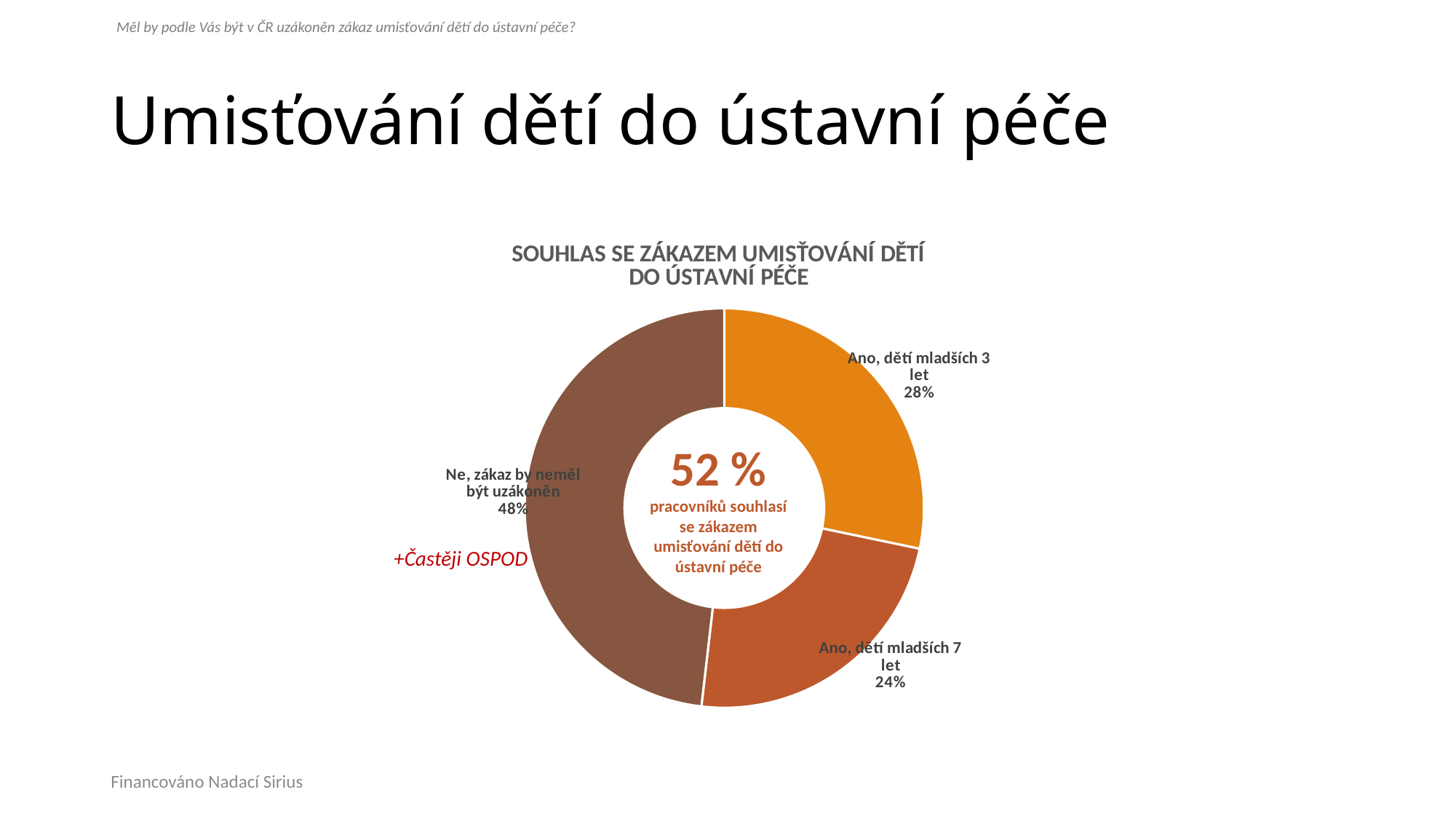
What is the combined share of the two "Ano" categories? 52% What is the difference in percentage points between "Ne, zákaz by neměl být uzákoněn" and "Ano, dětí mladších 3 let"? 20 percentage points What is the title of the chart? SOUHLAS SE ZÁKAZEM UMISŤOVÁNÍ DĚTÍ DO ÚSTAVNÍ PÉČE Which is larger: the share for "Ano, dětí mladších 3 let" or for "Ano, dětí mladších 7 let"? Ano, dětí mladších 3 let Which category has the largest share of the chart? Ne, zákaz by neměl být uzákoněn What percentage is printed in the centre of the doughnut chart? 52 % What share of the chart is labelled "Ano, dětí mladších 3 let"? 28% Which category has the smallest share of the chart? Ano, dětí mladších 7 let What kind of chart is shown on the slide? Doughnut (pie) chart What share of the chart is labelled "Ne, zákaz by neměl být uzákoněn"? 48% What share of the chart is labelled "Ano, dětí mladších 7 let"? 24% How many categories does the chart show? 3